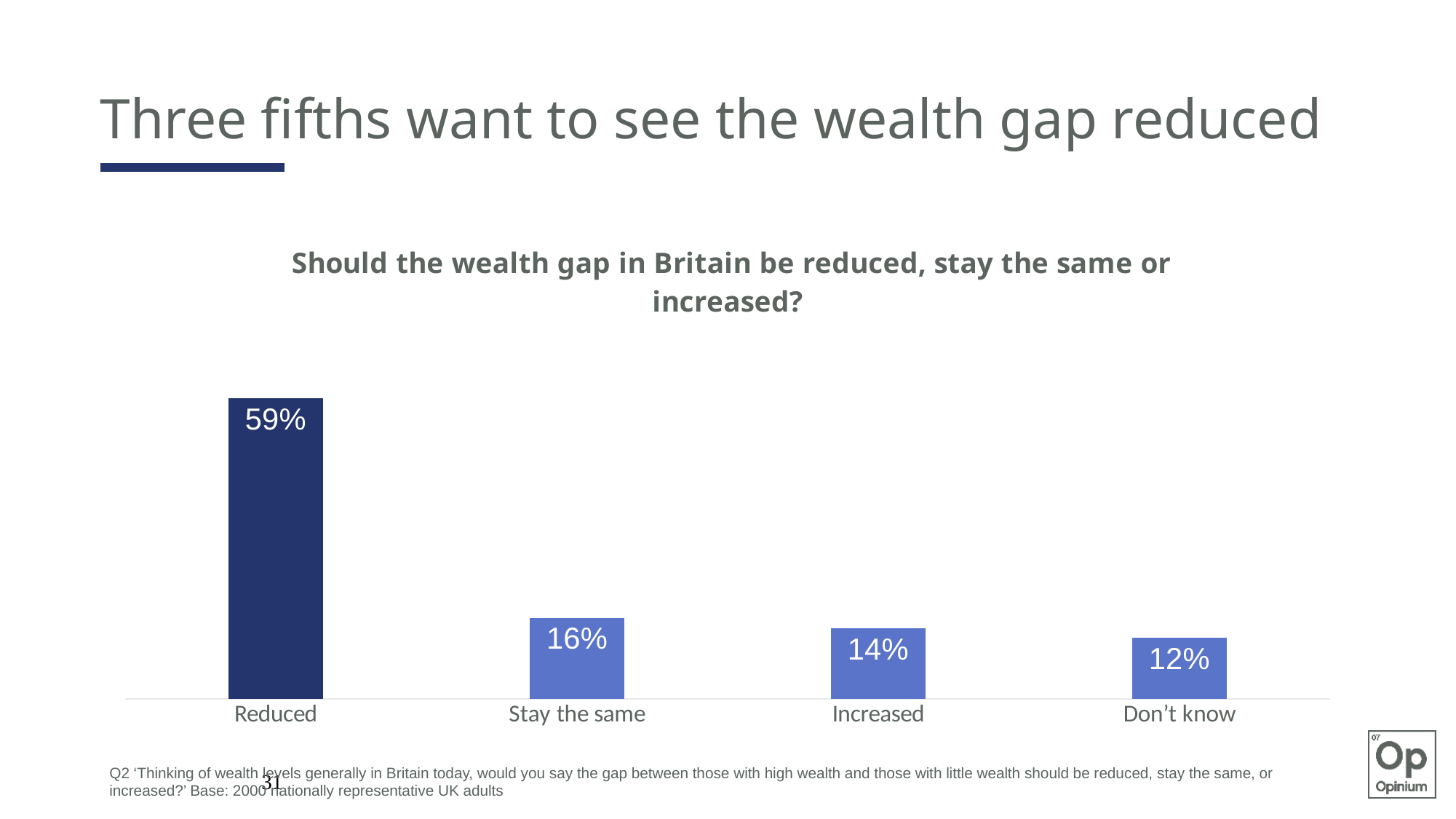
What is the difference between the values for 'Reduced' and 'Stay the same'? 43% Which category has the lowest value? Don't know Which category has the highest value? Reduced How many categories are shown in the chart? 4 What is the difference between the values for 'Increased' and 'Don't know'? 2% What is the title of the chart? Should the wealth gap in Britain be reduced, stay the same or increased? What is the value shown for 'Don't know'? 12% What is the value shown for 'Increased'? 14% What percentage of respondents said the wealth gap should be reduced? 59% What kind of chart is shown on the slide? Bar chart Which is larger, the value for 'Stay the same' or the value for 'Increased'? Stay the same What is the value shown for 'Stay the same'? 16%